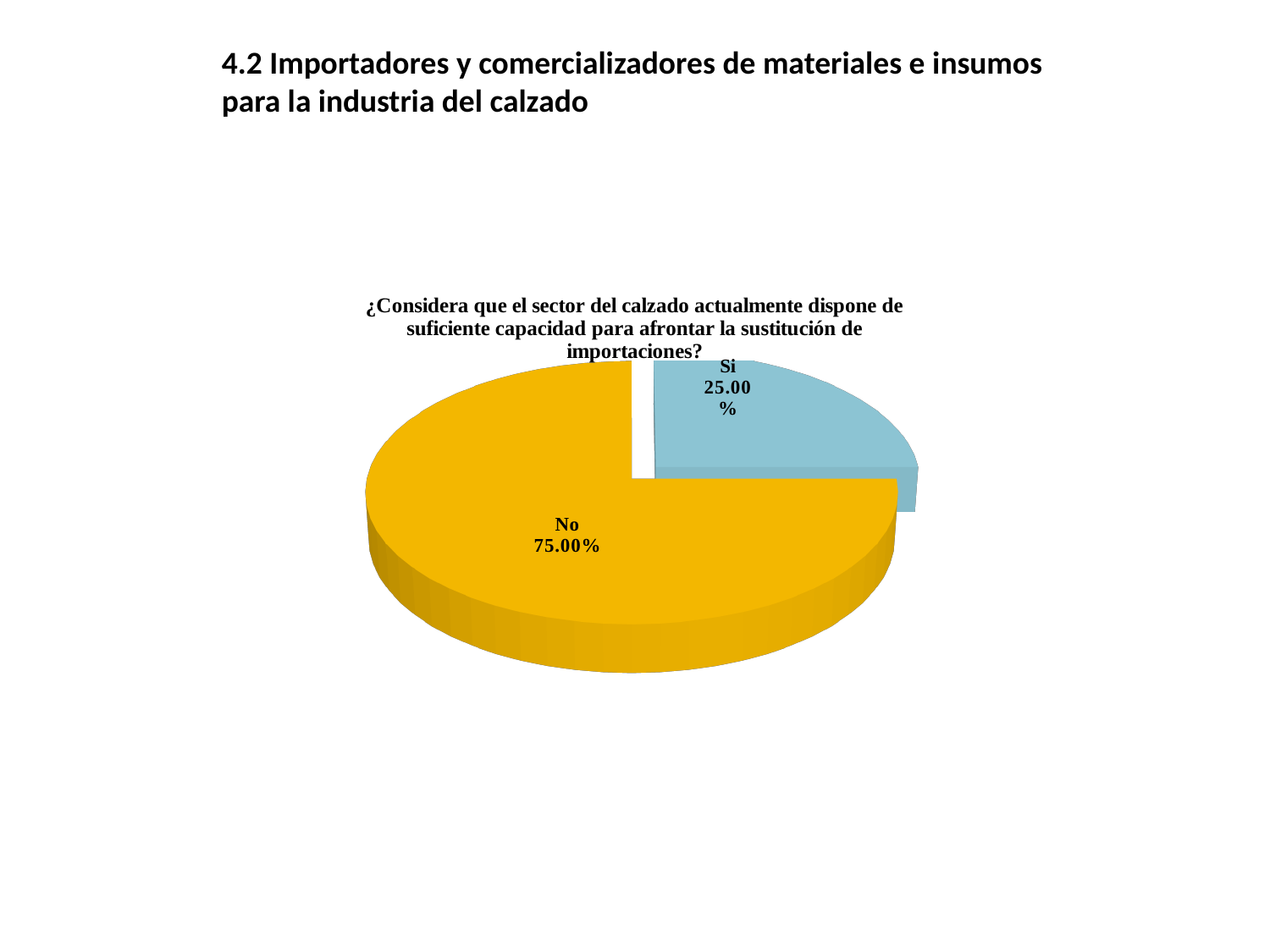
What percentage of respondents answered "Si"? 25.00% What is the difference in percentage points between the "No" and "Si" slices? 50.00% Which response has the smallest share of the pie? Si What question does the chart title ask? ¿Considera que el sector del calzado actualmente dispone de suficiente capacidad para afrontar la sustitución de importaciones? What colour is the "No" slice? yellow Which slice is larger, "Si" or "No"? No What percentage of respondents answered "No"? 75.00% What kind of chart is shown on the slide? pie chart How many slices does the pie chart have? 2 What share of the pie does the "Si" slice represent? 25.00% Which response has the largest share of the pie? No